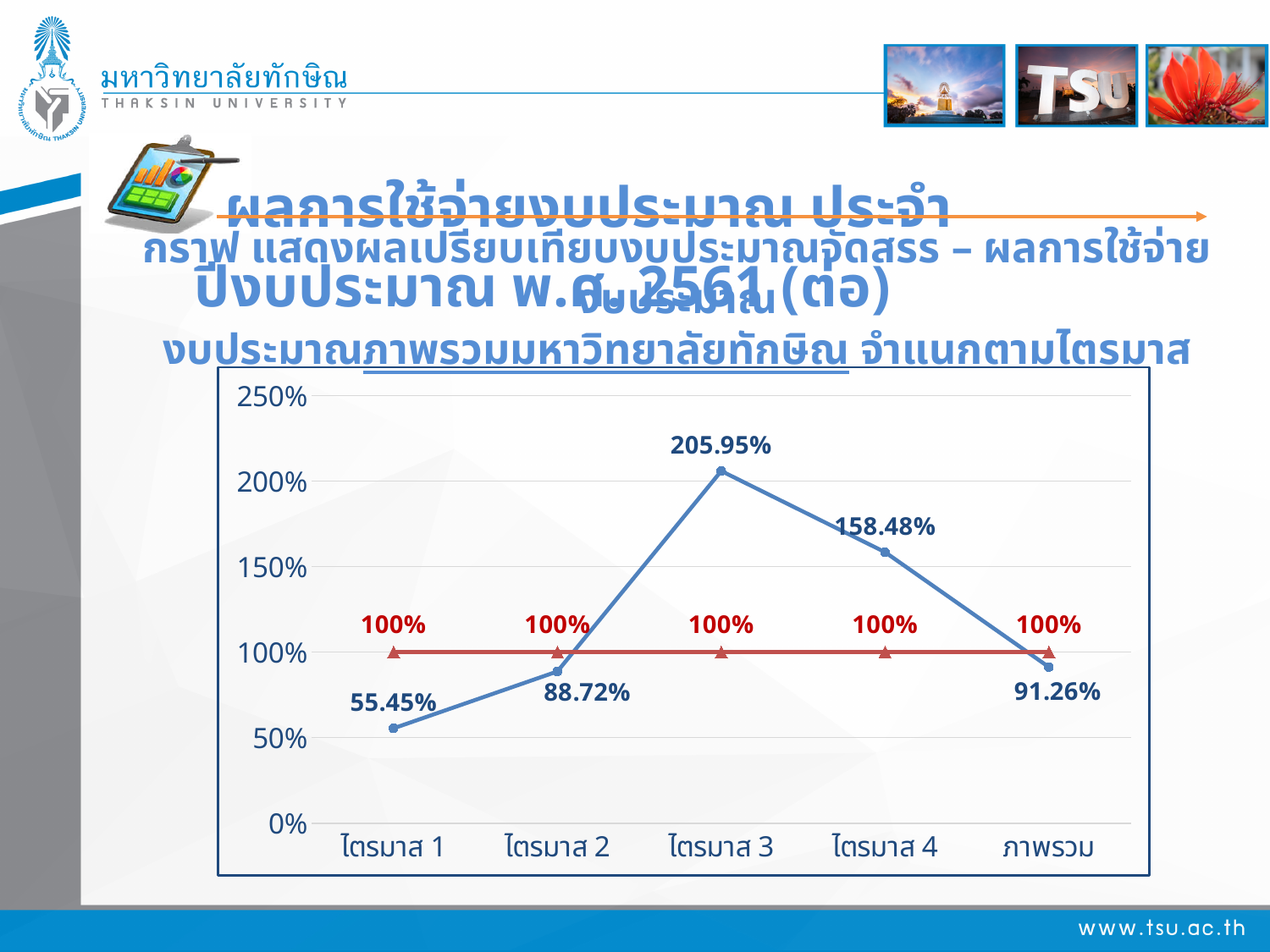
What is the difference between the blue line values for ไตรมาส 3 and ไตรมาส 4? 47.47% Which category has the highest value on the blue line? ไตรมาส 3 What is the value of the blue line for ภาพรวม? 91.26% What is the value of the blue line for ไตรมาส 1? 55.45% What is the value of the red line for ไตรมาส 4? 100% How many categories are shown on the x axis? 5 Is the blue line value for ไตรมาส 4 greater or less than 150%? greater Which category has the lowest value on the blue line? ไตรมาส 1 What kind of chart is shown on the slide? line chart Does the blue line rise or fall from ไตรมาส 1 to ไตรมาส 3? rise Which is larger on the blue line: ไตรมาส 2 or ภาพรวม? ภาพรวม What is the value of the blue line for ไตรมาส 3? 205.95%